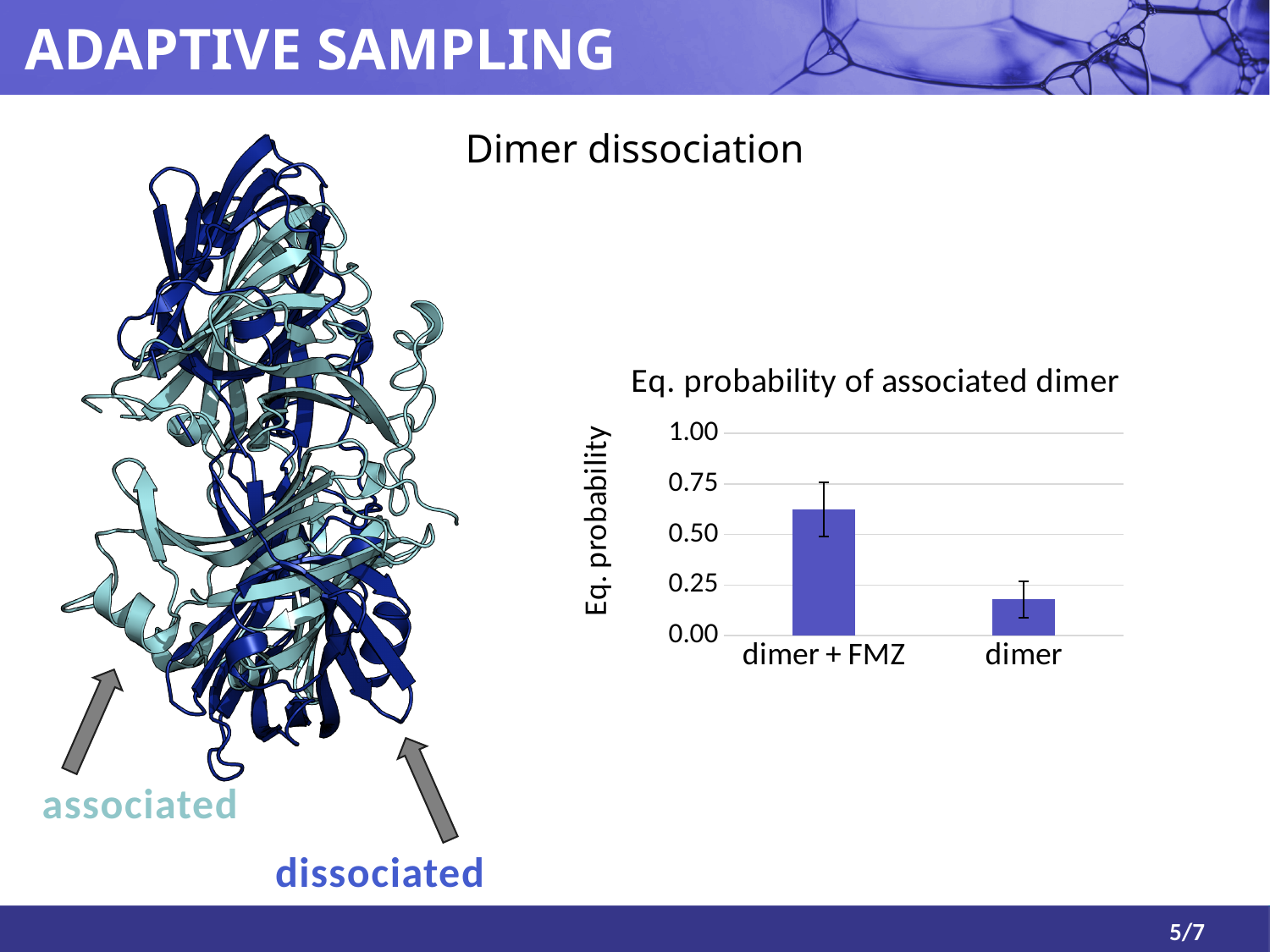
Is the value for dimer + FMZ greater or less than 0.50? greater What kind of chart is shown on the slide? bar chart Which is larger, the value for dimer + FMZ or the value for dimer? dimer + FMZ Do the bar values rise or fall from left to right along the x axis? fall What is the label of the y axis? Eq. probability Is the value for dimer + FMZ greater or less than 0.75? less How many categories are plotted in the chart? 2 Which category has the lowest equilibrium probability? dimer Is the value for dimer greater or less than 0.25? less What is the title of the chart? Eq. probability of associated dimer Which category has the highest equilibrium probability? dimer + FMZ What is the highest tick value shown on the y axis? 1.00